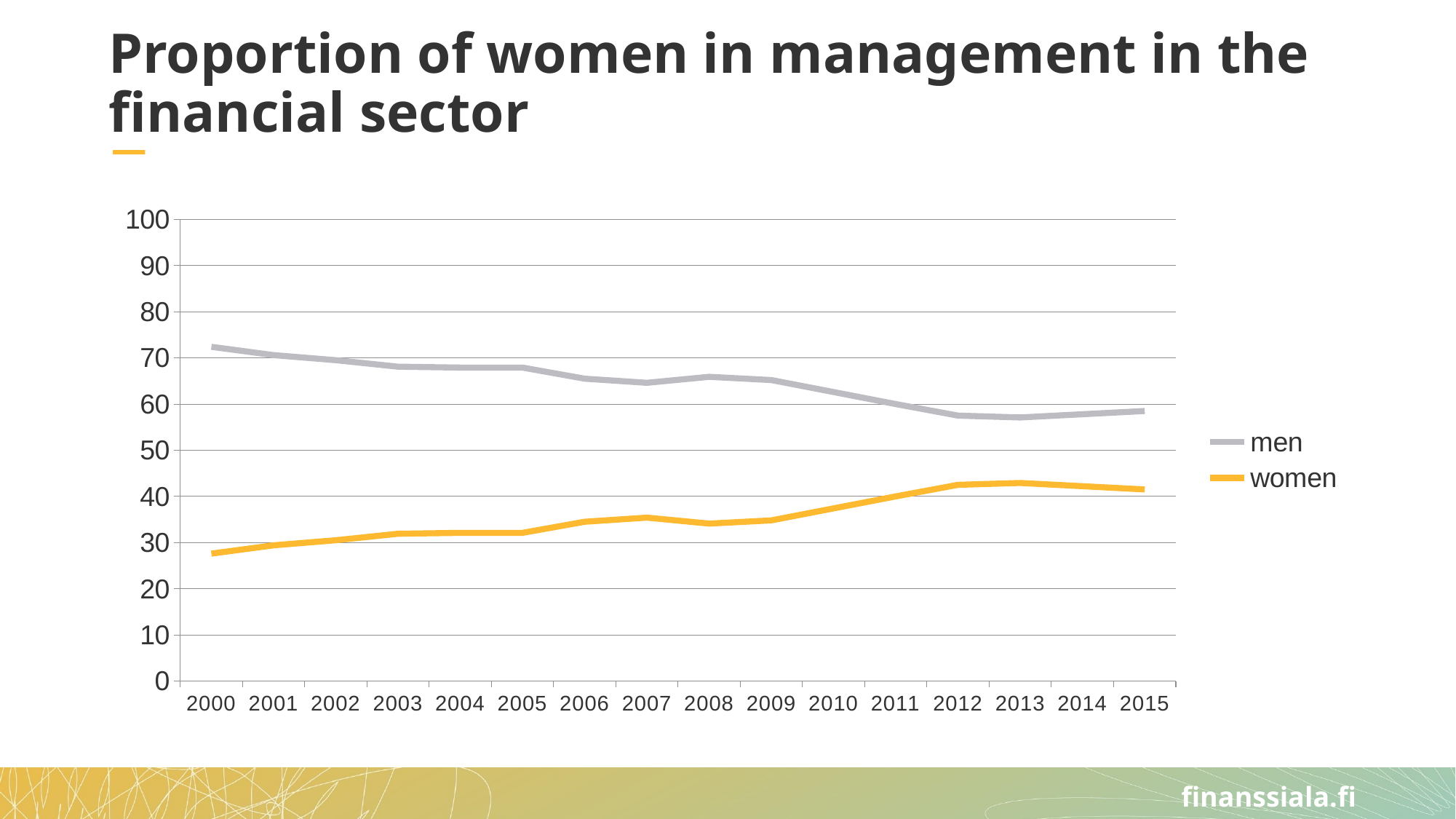
In which year is the value for men highest? 2000 Which series has the larger value in 2010, men or women? men In which year is the value for women lowest? 2000 What kind of chart is shown on the slide? line chart How many series does the legend list? 2 Is the value for women in 2000 greater or less than 30? less How many years are plotted along the x axis? 16 Does the men series rise or fall overall from 2000 to 2015? fall Is the value for women in 2013 greater or less than 40? greater Is the value for men in 2013 greater or less than 60? less Does the women series rise or fall overall from 2000 to 2015? rise